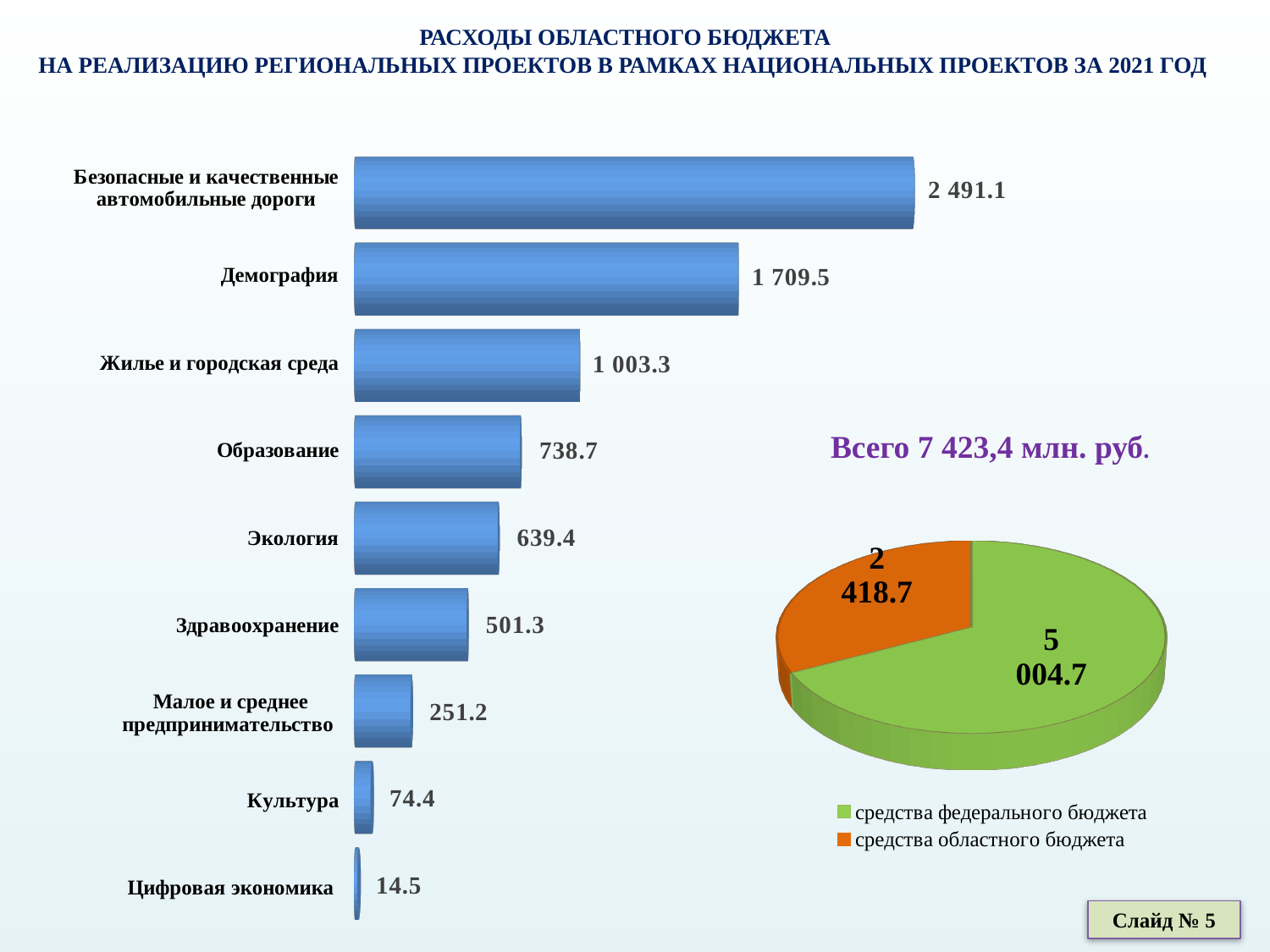
On the bar chart on the left, which category has the highest value? Безопасные и качественные автомобильные дороги What kind of chart is the chart on the left of the slide? Bar chart On the bar chart on the left, which category has the lowest value? Цифровая экономика How many categories are shown on the bar chart on the left? 9 On the pie chart on the right, which colour represents средства областного бюджета? Orange How many entries does the legend of the pie chart on the right list? 2 On the bar chart on the left, which is larger: the value for Жилье и городская среда or the value for Демография? Демография On the pie chart on the right, what is the value for средства областного бюджета? 2 418.7 On the bar chart on the left, what is the value for Здравоохранение? 501.3 On the bar chart on the left, what is the value for Демография? 1 709.5 On the bar chart on the left, what is the difference between the values for Образование and Экология? 99.3 On the pie chart on the right, what is the value for средства федерального бюджета? 5 004.7